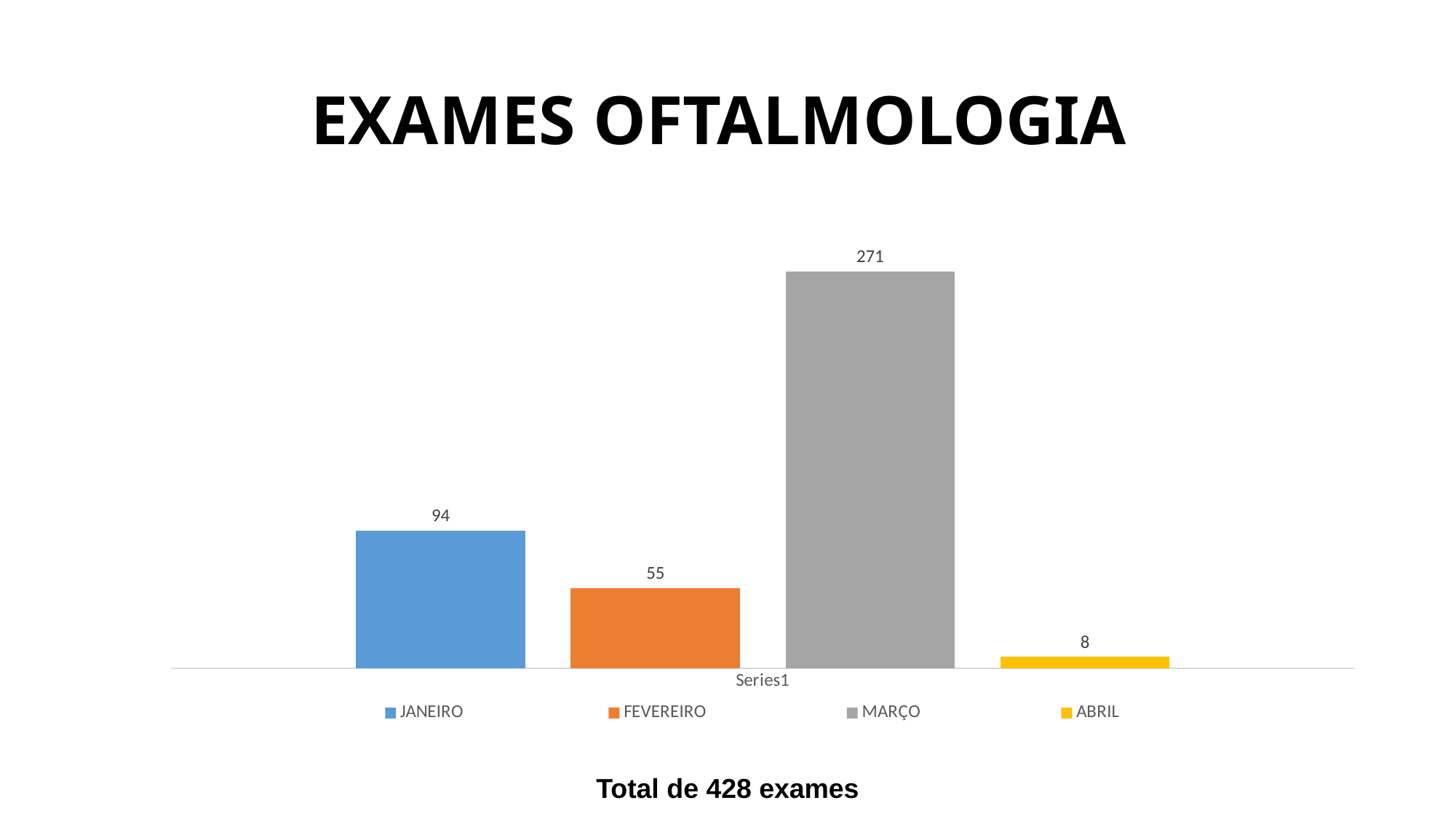
What kind of chart is shown on the slide? Bar chart What is the title of the slide? EXAMES OFTALMOLOGIA What is the value for FEVEREIRO? 55 How many series does the legend list? 4 What is the value for ABRIL? 8 Which month has the highest value? MARÇO What is the difference between the values for JANEIRO and FEVEREIRO? 39 Which month has the lowest value? ABRIL What is the value for MARÇO? 271 Which is larger, the value for JANEIRO or the value for FEVEREIRO? JANEIRO What is the value for JANEIRO? 94 What is the difference between the values for MARÇO and JANEIRO? 177